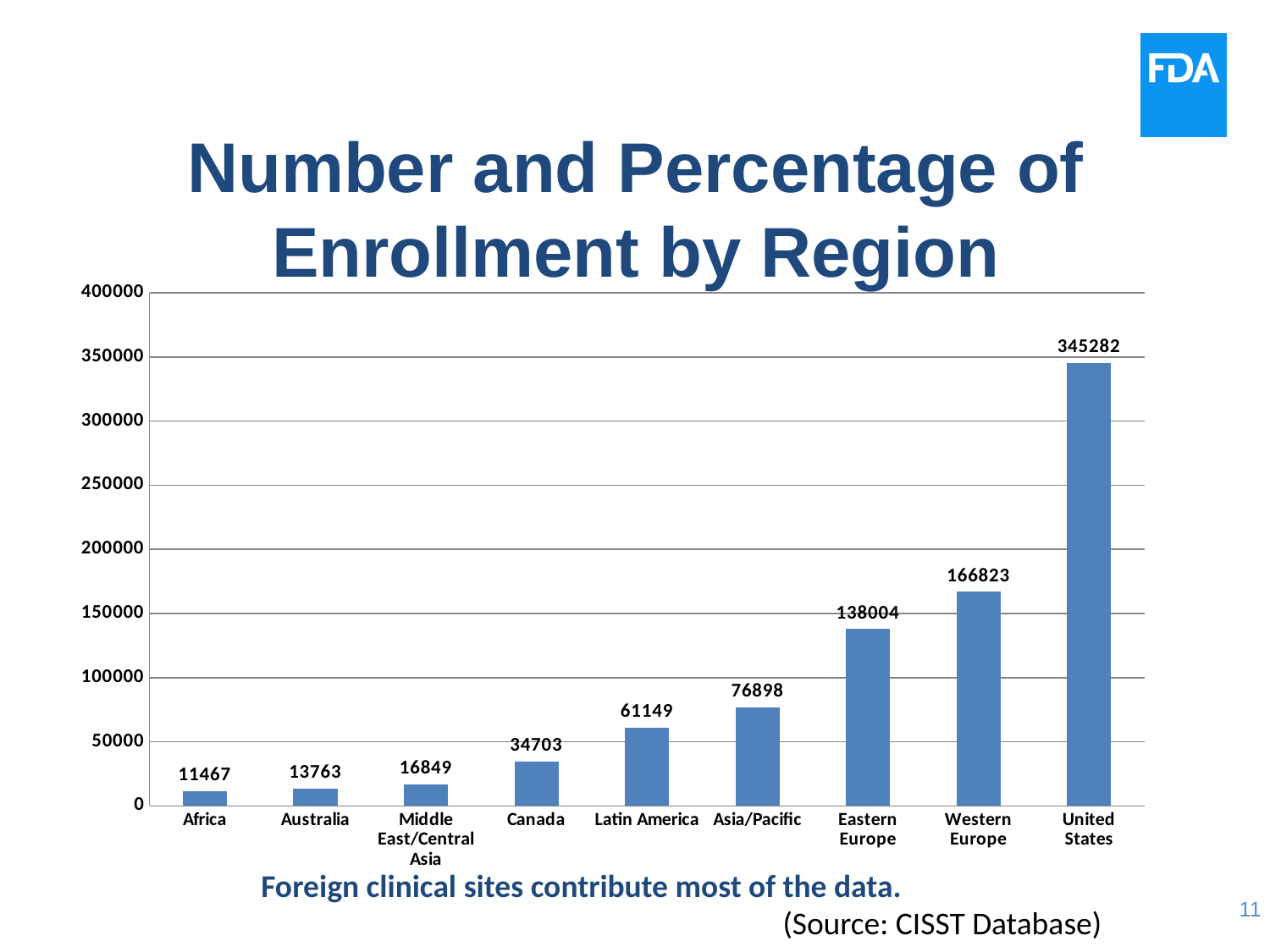
Do the enrollment values rise or fall from left to right across the regions? Rise What kind of chart is shown on the slide? Bar chart Which has a larger enrollment, Latin America or Asia/Pacific? Asia/Pacific Which region has the highest enrollment? United States What is the difference in enrollment between the United States and Western Europe? 178459 What is the enrollment value for Canada? 34703 What is the difference in enrollment between Western Europe and Eastern Europe? 28819 How many regions are shown on the chart? 9 Is the value for Western Europe greater or less than 150000? greater Which region has the lowest enrollment? Africa What is the enrollment value for Asia/Pacific? 76898 What is the enrollment value for Eastern Europe? 138004